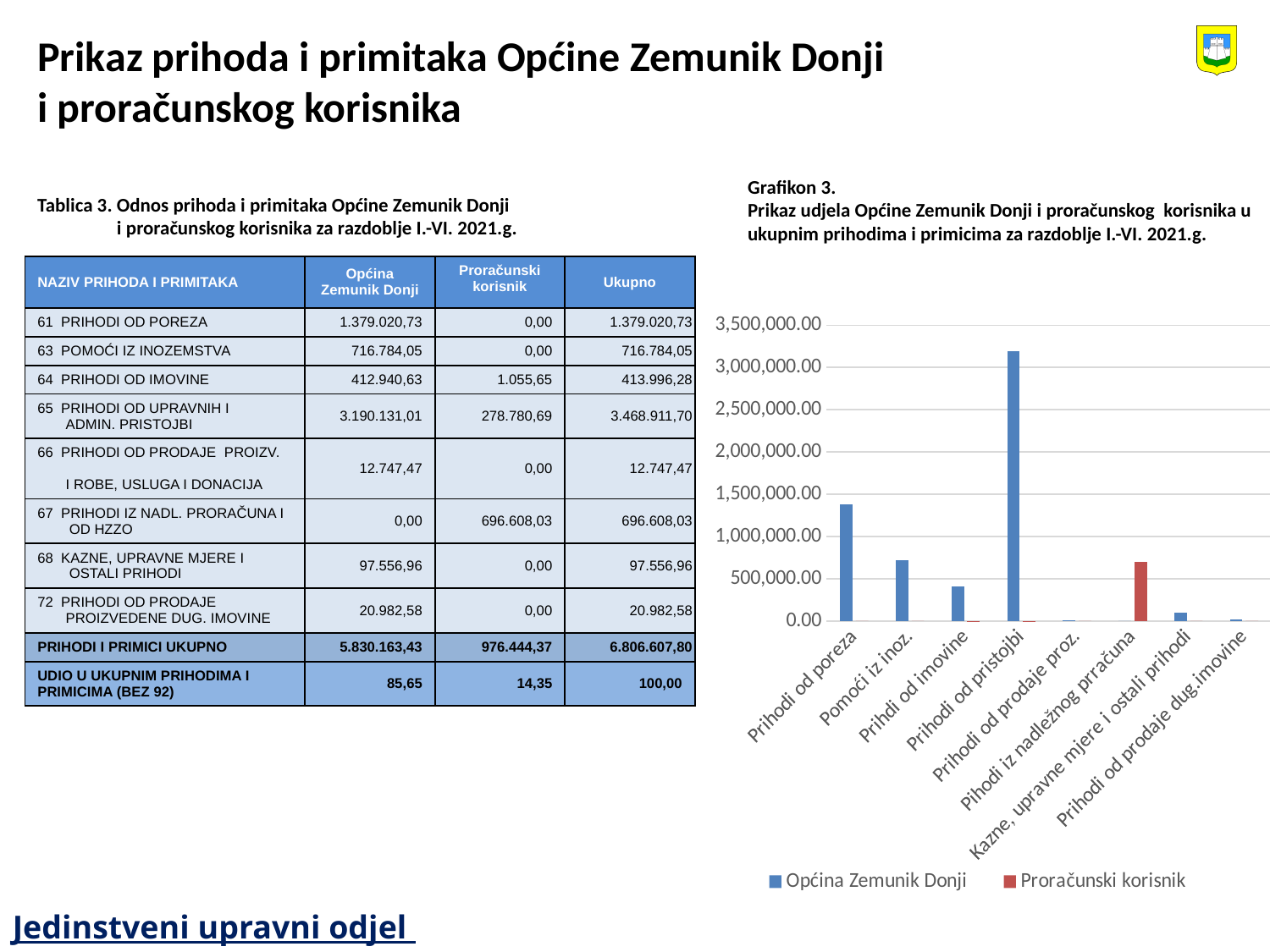
Is the Općina Zemunik Donji value for Prihodi od pristojbi greater or less than 3,000,000.00? greater How many series does the chart legend list? 2 What kind of chart is shown on the slide? bar chart Is the Proračunski korisnik value for Prihodi iz nadležnog prračuna greater or less than 1,000,000.00? less For the Općina Zemunik Donji series, which is larger: Prihodi od poreza or Pomoći iz inoz.? Prihodi od poreza Is the Općina Zemunik Donji value for Prihodi od poreza greater or less than 1,000,000.00? greater Which colour represents the Proračunski korisnik series in the chart? red What is the number of the chart (Grafikon) shown on the slide? Grafikon 3. Which category has the highest value for the Općina Zemunik Donji series? Prihodi od pristojbi How many categories are shown on the x axis of the chart? 8 Which category has the highest value for the Proračunski korisnik series? Pihodi iz nadležnog prračuna